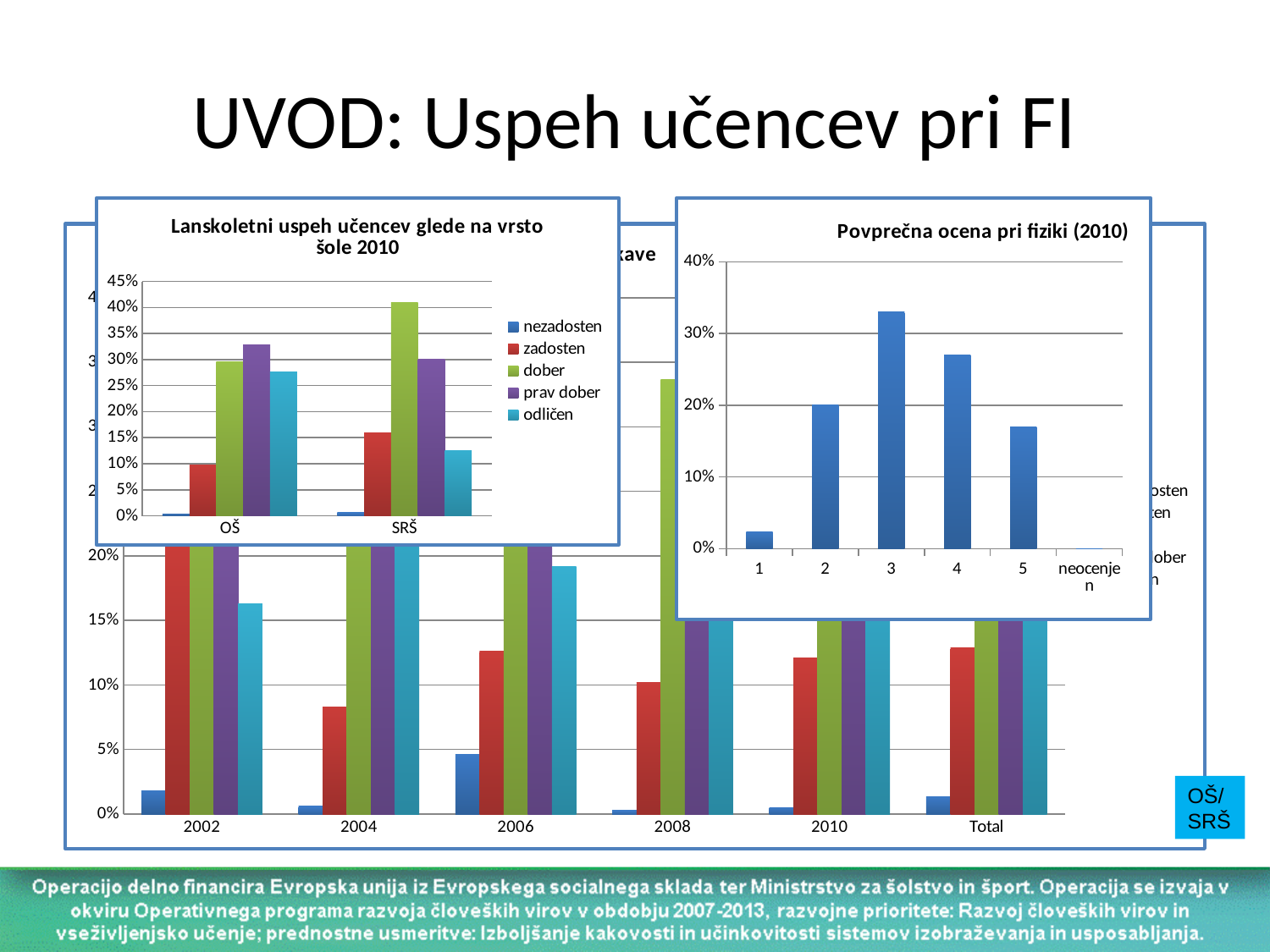
In the chart titled 'Povprečna ocena pri fiziki (2010)', is the value for category 2 greater or less than 10%? greater How many categories are shown on the x axis of the chart titled 'Povprečna ocena pri fiziki (2010)'? 6 In the chart titled 'Lanskoletni uspeh učencev glede na vrsto šole 2010', which series has the highest value for SRŠ? dober In the chart titled 'Povprečna ocena pri fiziki (2010)', is the value for category 3 greater or less than 30%? greater What kind of chart is 'Povprečna ocena pri fiziki (2010)'? bar chart In the chart titled 'Povprečna ocena pri fiziki (2010)', is the value for category 1 greater or less than 10%? less How many series does the legend list in the chart titled 'Lanskoletni uspeh učencev glede na vrsto šole 2010'? 5 In the chart titled 'Lanskoletni uspeh učencev glede na vrsto šole 2010', which has the larger 'zadosten' value, OŠ or SRŠ? SRŠ In the chart titled 'Povprečna ocena pri fiziki (2010)', which category has the highest value? 3 In the chart titled 'Povprečna ocena pri fiziki (2010)', which is larger, the value for category 4 or category 5? 4